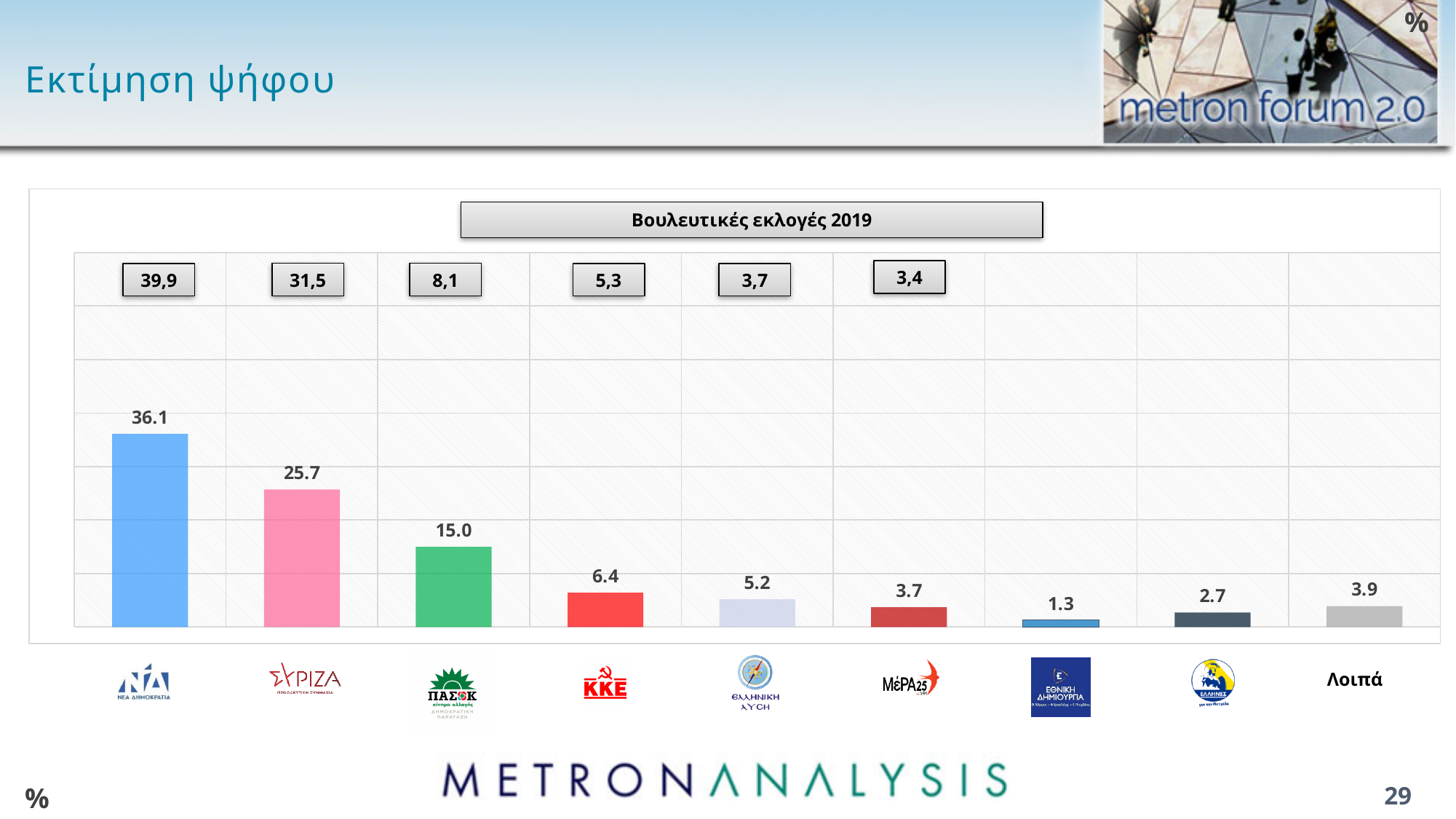
What is the difference between the vote estimate for ΝΕΑ ΔΗΜΟΚΡΑΤΙΑ and ΣΥΡΙΖΑ? 10.4 Which party has the highest vote estimate bar? ΝΕΑ ΔΗΜΟΚΡΑΤΙΑ What is the vote estimate value shown for ΣΥΡΙΖΑ? 25.7 What kind of chart is shown on the slide? Bar chart What 2019 parliamentary election result (Βουλευτικές εκλογές 2019) is shown in the box above the ΝΕΑ ΔΗΜΟΚΡΑΤΙΑ bar? 39,9 What is the vote estimate value shown for Λοιπά? 3.9 Which has a larger vote estimate, ΠΑΣΟΚ or ΚΚΕ? ΠΑΣΟΚ How many bars are plotted in the chart? 9 Which party has the lowest vote estimate bar? ΕΘΝΙΚΗ ΔΗΜΙΟΥΡΓΙΑ What is the vote estimate value shown for ΝΕΑ ΔΗΜΟΚΡΑΤΙΑ? 36.1 What is the vote estimate value shown for ΚΚΕ? 6.4 What is the title of the slide? Εκτίμηση ψήφου